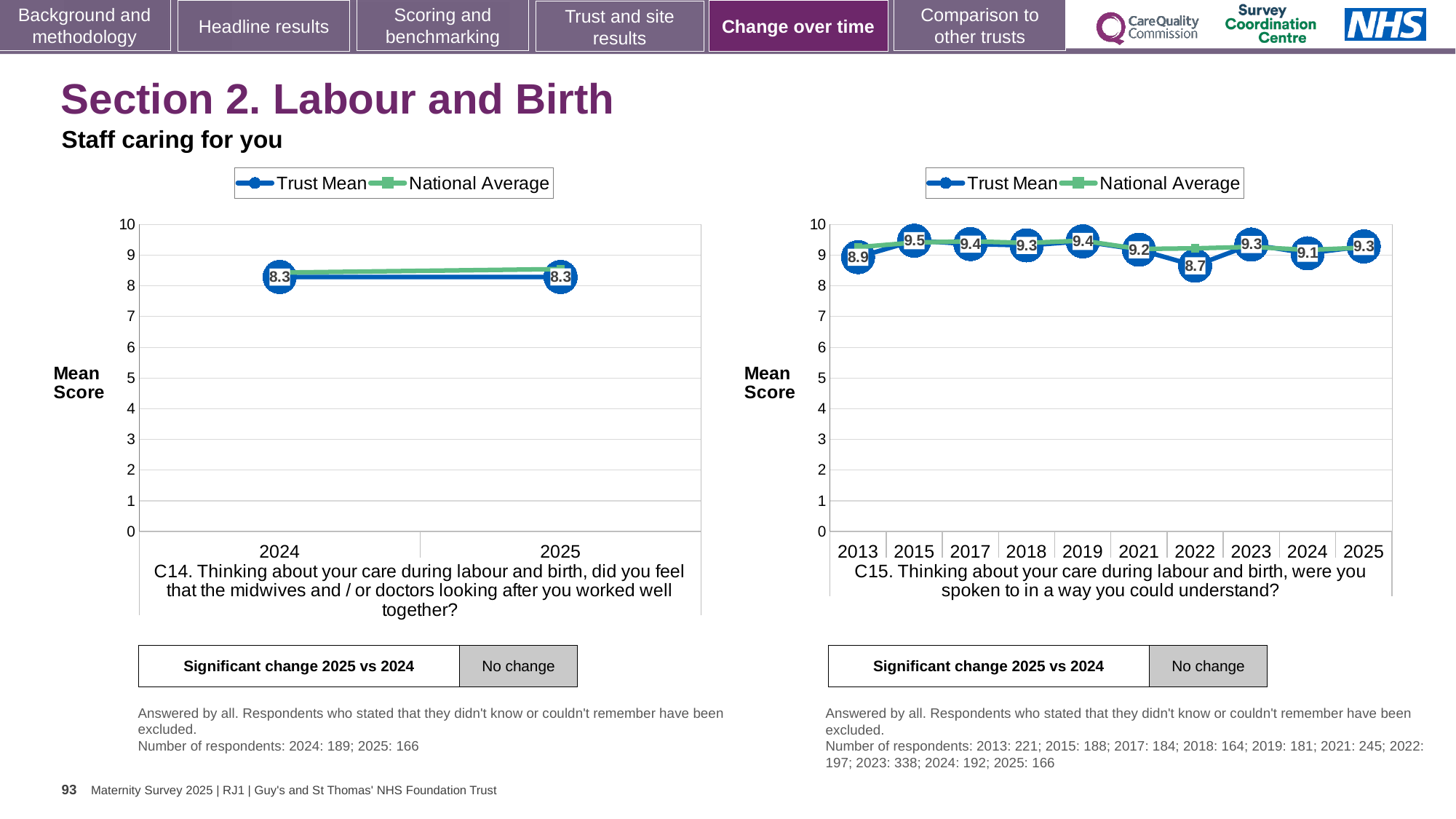
On the right chart (C15), what is the difference between the Trust Mean scores for 2015 and 2022? 0.8 On the right chart (C15), is the Trust Mean score for 2023 larger or smaller than the score for 2024? larger How many years are shown on the x axis of the left chart (C14)? 2 What kind of chart is the left chart (C14)? line chart On the right chart (C15), which year has the lowest Trust Mean score? 2022 On the left chart (C14), what is the Trust Mean score for 2025? 8.3 How many series does the legend of the left chart (C14) list? 2 How many years are shown on the x axis of the right chart (C15)? 10 On the right chart (C15), what is the Trust Mean score for 2013? 8.9 On the right chart (C15), what is the Trust Mean score for 2022? 8.7 On the right chart (C15), which year has the highest Trust Mean score? 2015 On the left chart (C14), what is the Trust Mean score for 2024? 8.3